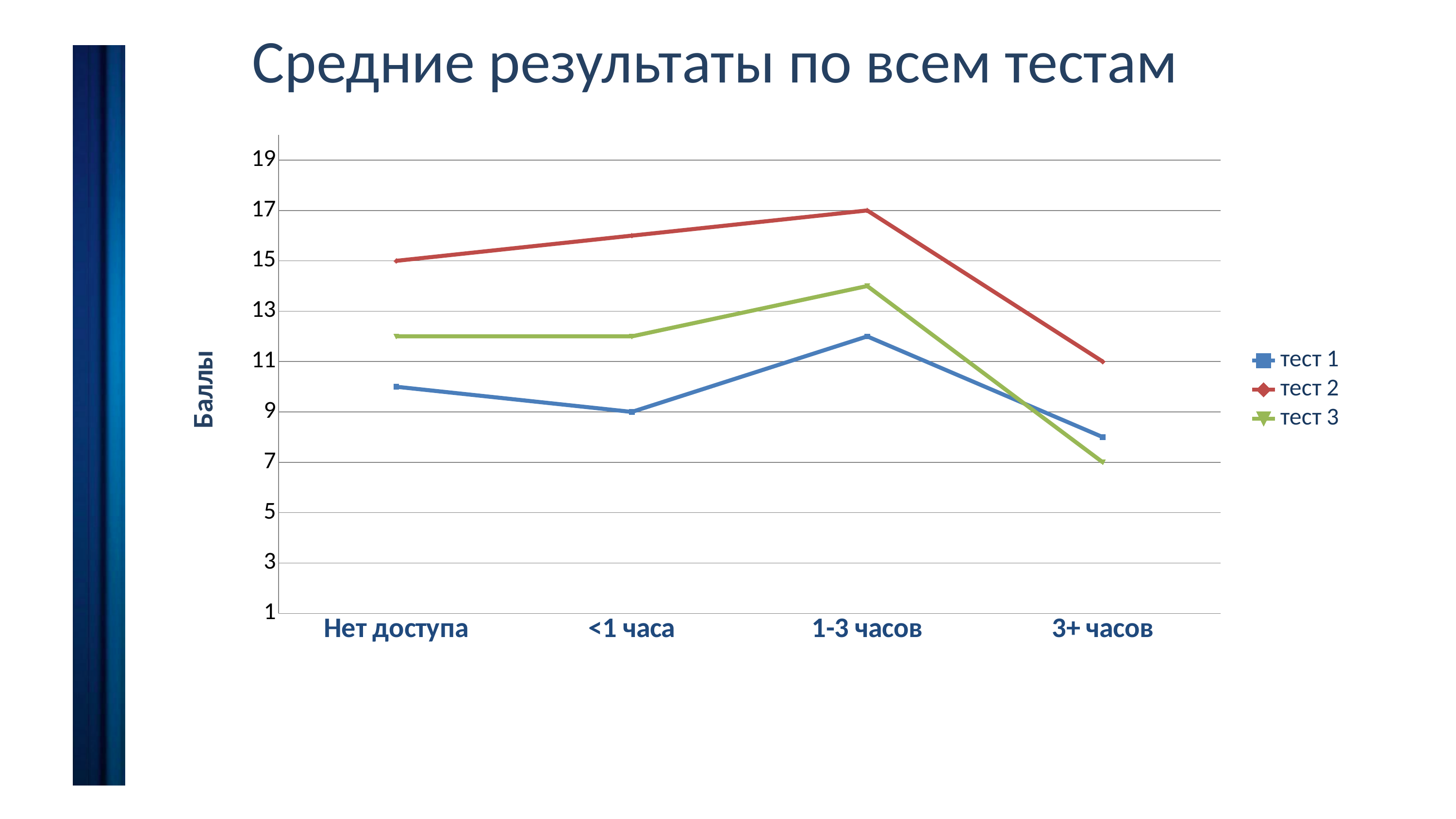
How many series does the legend list? 3 For which category is тест 3 lowest? 3+ часов What is the value of тест 2 for Нет доступа? 15 What is the difference between тест 2 for 1-3 часов and тест 2 for 3+ часов? 6 For which category does тест 2 reach its highest value? 1-3 часов How many categories are shown on the x axis? 4 What is the value of тест 3 for 3+ часов? 7 Is the value of тест 3 for 1-3 часов greater or less than 13? greater What kind of chart is shown on the slide? line chart What is the value of тест 1 for <1 часа? 9 What is the title of the vertical axis? Баллы What is the value of тест 2 for 1-3 часов? 17